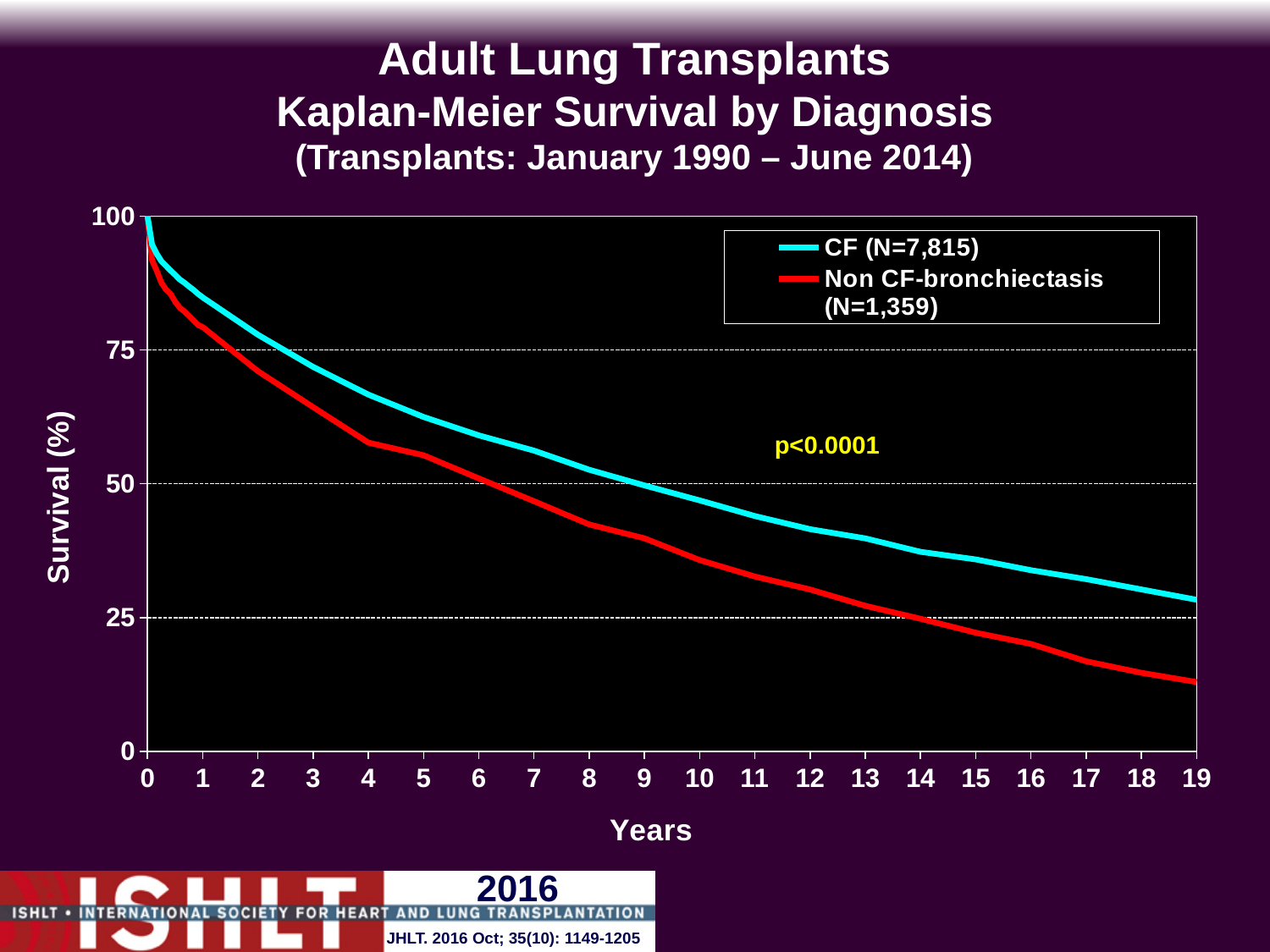
What kind of chart is shown on the slide? line chart How many series does the legend list? 2 Is the survival value for CF at 4 years greater or less than 75? less Is the survival value for CF at 19 years greater or less than 25? greater Is the survival value for Non CF-bronchiectasis at 19 years greater or less than 25? less What is the title of the chart? Adult Lung Transplants Kaplan-Meier Survival by Diagnosis (Transplants: January 1990 – June 2014) At 10 years, which series has higher survival: CF or Non CF-bronchiectasis? CF Do the survival curves rise or fall as years increase? fall What p-value is printed on the chart? p<0.0001